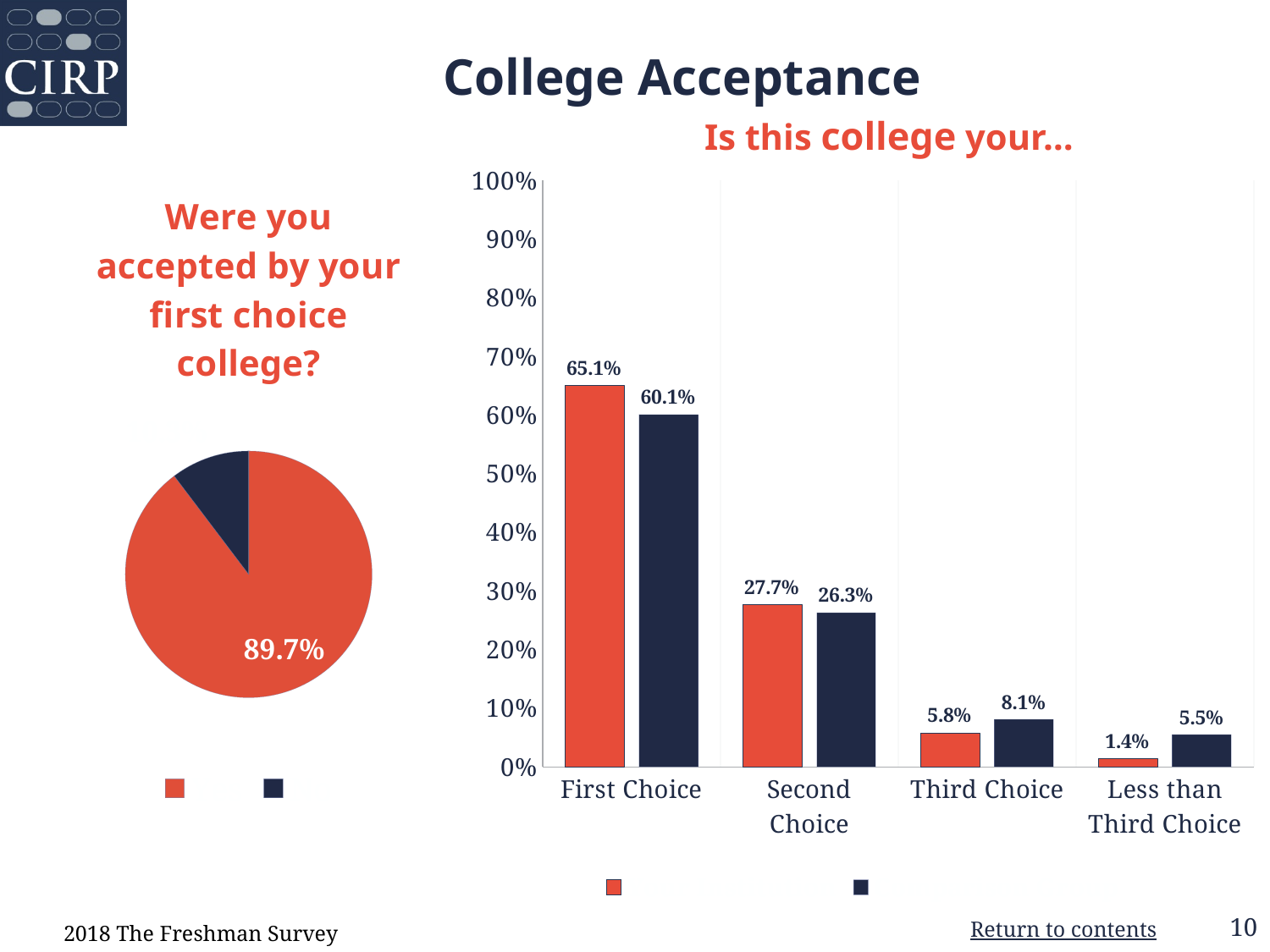
In the bar chart 'Is this college your...', what is the difference between the orange and navy bars for First Choice? 5.0% In the bar chart 'Is this college your...', which category has the highest orange bar? First Choice In the bar chart 'Is this college your...', do the orange bars rise or fall from left to right? fall How many categories are shown on the x axis of the bar chart 'Is this college your...'? 4 In the bar chart 'Is this college your...', for Third Choice, is the orange bar or the navy bar larger? navy In the bar chart 'Is this college your...', what is the value of the navy bar for Second Choice? 26.3% In the bar chart 'Is this college your...', what is the value of the orange bar for First Choice? 65.1% In the bar chart 'Is this college your...', what is the value of the navy bar for Third Choice? 8.1% In the pie chart 'Were you accepted by your first choice college?', what value is labelled on the orange slice? 89.7% What kind of chart is the chart titled 'Is this college your...'? bar chart In the bar chart 'Is this college your...', what is the value of the orange bar for Less than Third Choice? 1.4% In the bar chart 'Is this college your...', which category has the lowest navy bar? Less than Third Choice